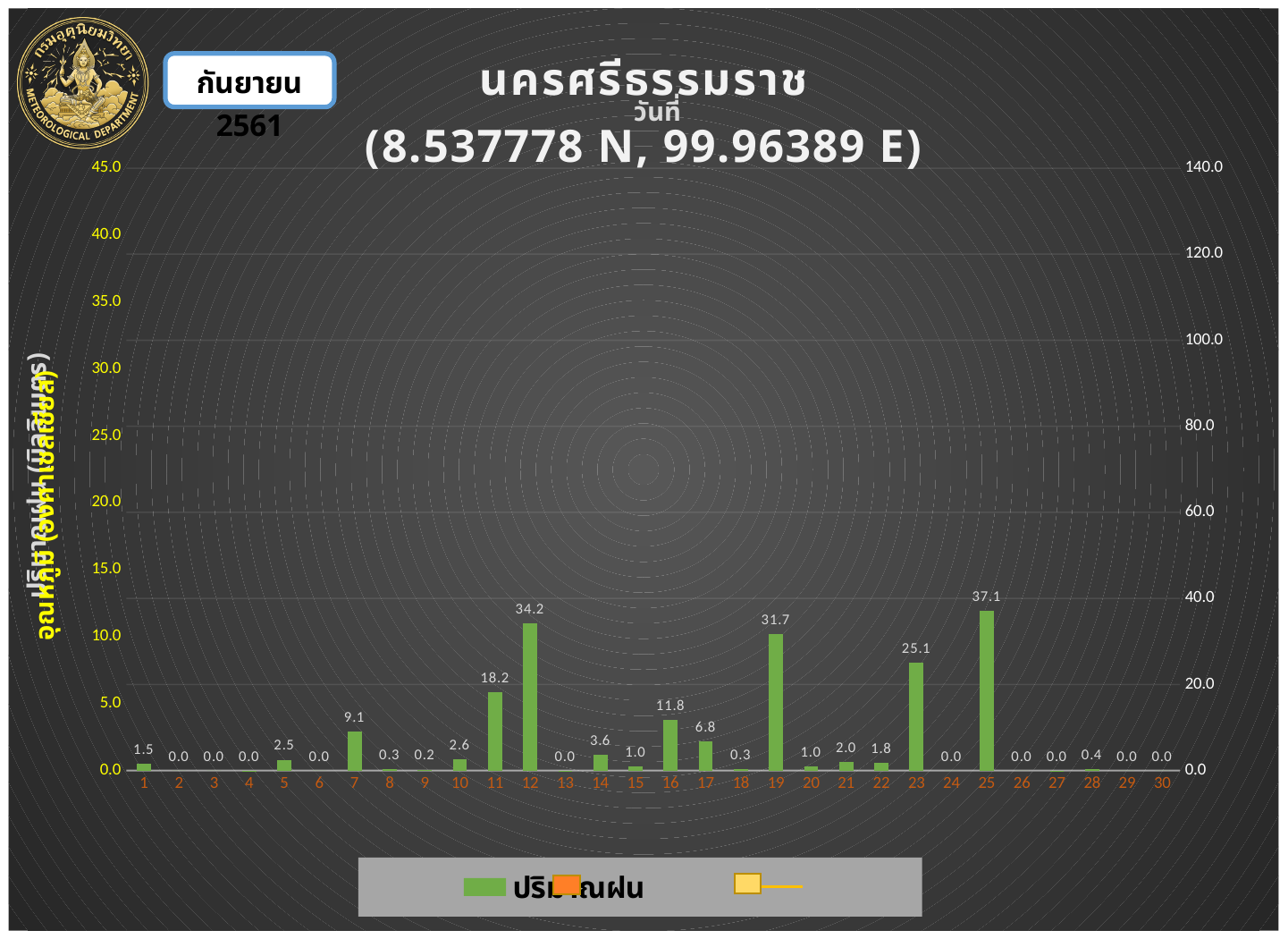
Which is larger, the value for day 11 or the value for day 16? day 11 What is the difference between the values for day 19 and day 23? 6.6 How many days have a labelled value of 0.0? 10 Which day has the highest bar in the chart? 25 What is the difference between the values for day 25 and day 12? 2.9 What kind of chart is shown on the slide? bar chart What is the rainfall value shown for day 12? 34.2 Which is larger, the value for day 12 or the value for day 19? day 12 What is the rainfall value shown for day 19? 31.7 How many days are shown on the x axis of the chart? 30 What is the value labelled for day 23? 25.1 What is the value labelled for day 7? 9.1